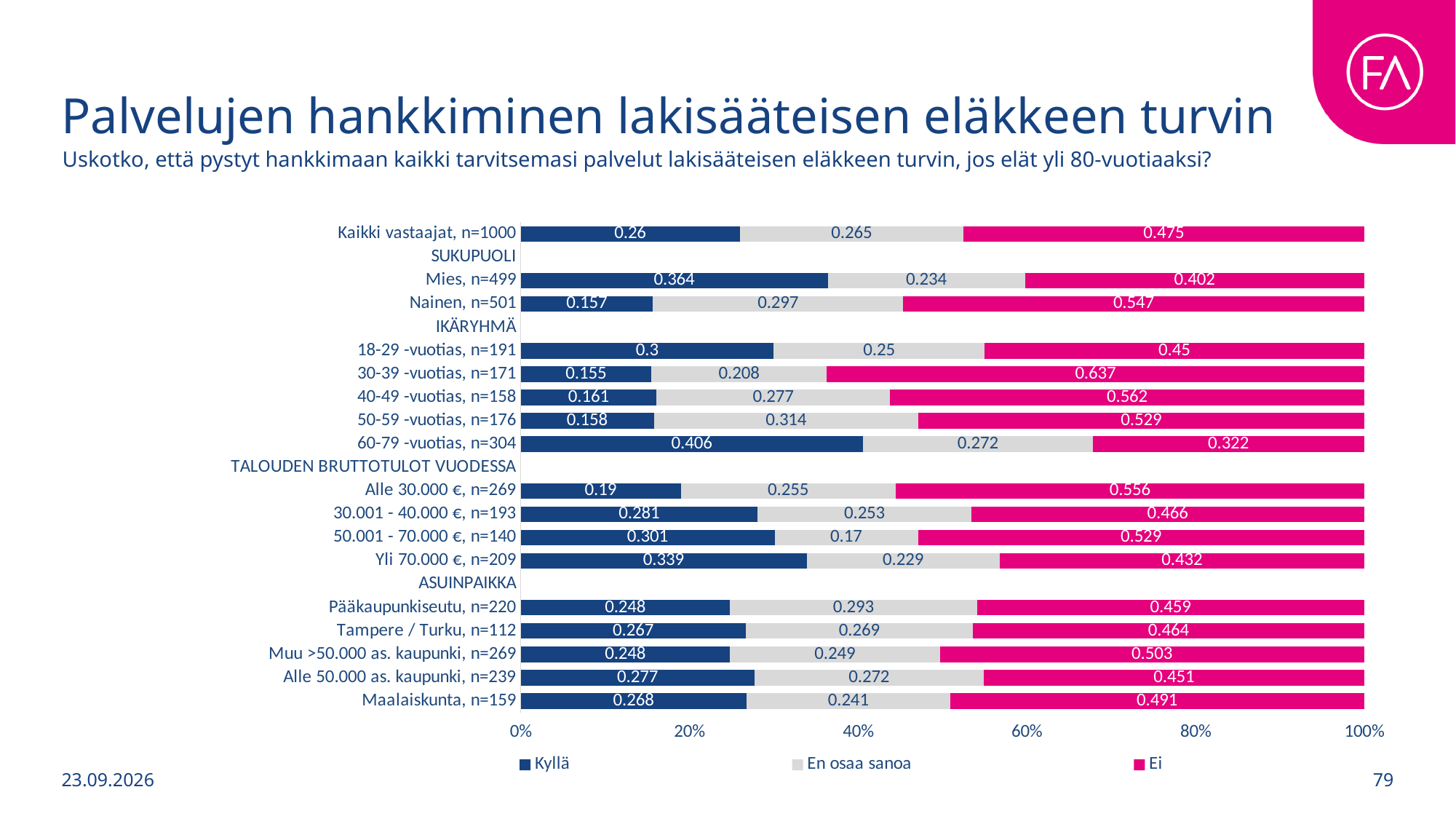
What is the Ei value for Maalaiskunta, n=159? 0.491 What is the En osaa sanoa value for 50-59 -vuotias, n=176? 0.314 Which group has the highest Kyllä value? 60-79 -vuotias, n=304 Which group has the highest Ei value? 30-39 -vuotias, n=171 Which has the larger Ei value, Mies, n=499 or Nainen, n=501? Nainen, n=501 Is the Kyllä value for Mies, n=499 greater or less than 40%? less What is the Kyllä value for Kaikki vastaajat, n=1000? 0.26 What is the Ei value for Nainen, n=501? 0.547 Which group has the lowest Ei value? 60-79 -vuotias, n=304 What is the difference between the Kyllä values for Mies, n=499 and Nainen, n=501? 0.207 How many series does the legend list? 3 What kind of chart is shown on the slide? stacked bar chart